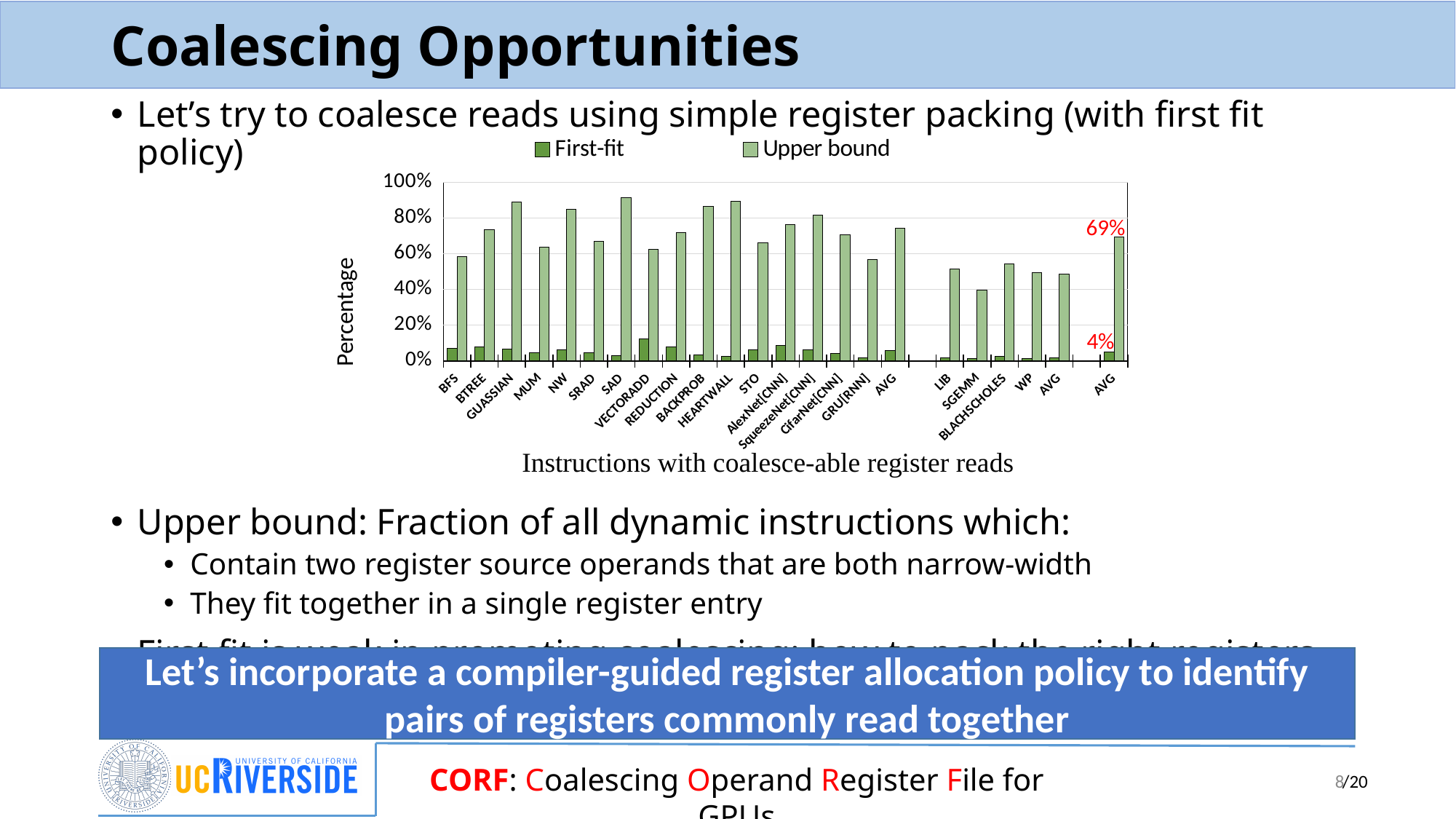
Which category has the highest First-fit value? VECTORADD How many series does the chart's legend list? 2 What kind of chart is shown on the slide? bar chart Is the Upper bound value for SAD greater or less than 80%? greater What is the Upper bound value for the final AVG category on the right of the chart? 69% Is the First-fit value for VECTORADD greater or less than 20%? less For the final AVG category, which series has the larger value, First-fit or Upper bound? Upper bound For the final AVG category, how much higher is the Upper bound value than the First-fit value? 65 percentage points Which category has the lowest Upper bound value? SGEMM What is the First-fit value for the final AVG category on the right of the chart? 4% Is the Upper bound value for MUM greater or less than 80%? less What are the two series named in the chart's legend? First-fit and Upper bound